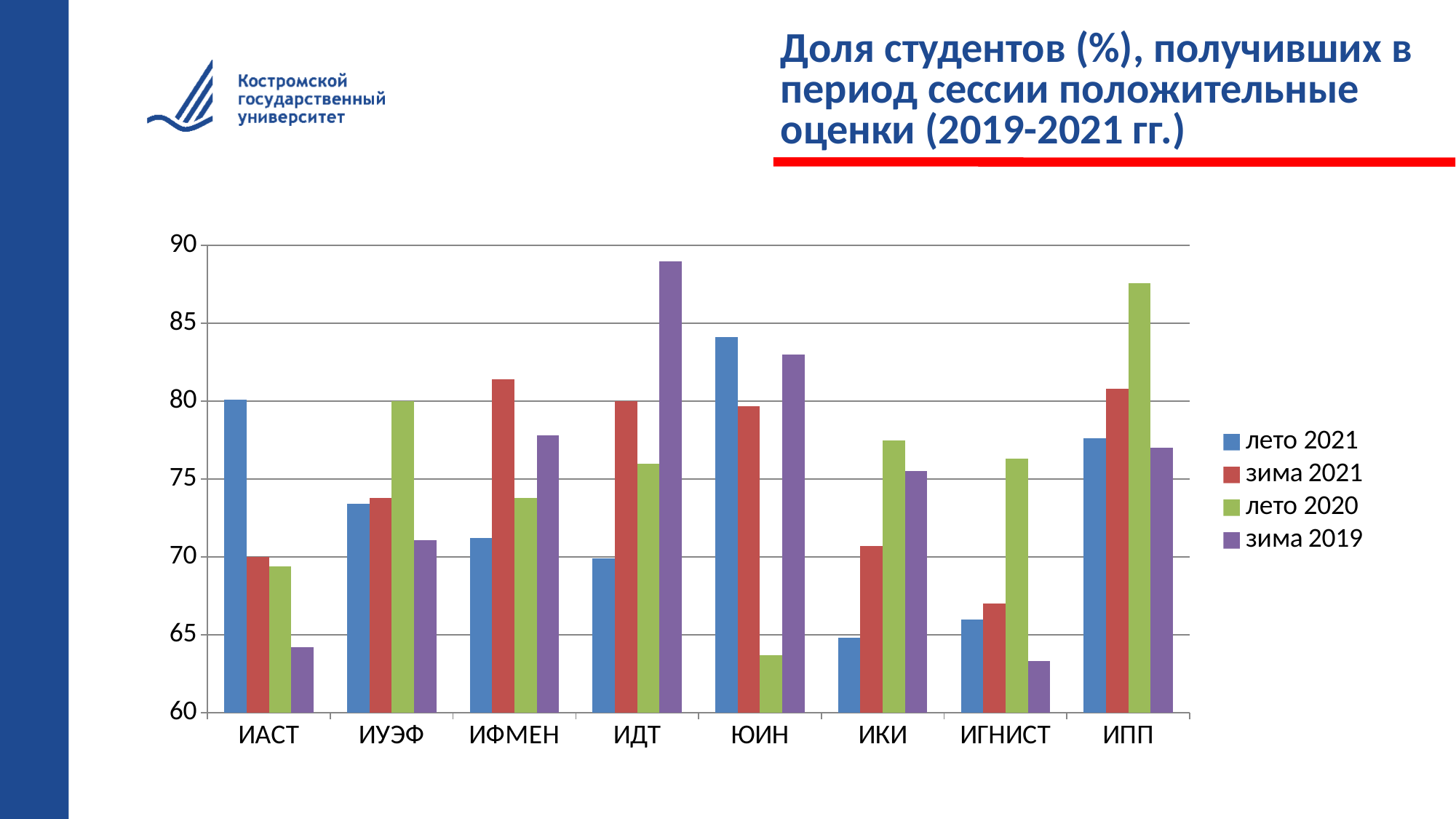
For ИАСТ, which series has the highest value? лето 2021 How many series does the legend list? 4 How many categories (institutes) are shown on the x axis? 8 Which category has the tallest bar in the whole chart? ИДТ Is the value for ЮИН in лето 2020 greater or less than 65? less For ИДТ, which series has the highest value? зима 2019 What kind of chart is shown on the slide? bar chart Is the value for ИФМЕН in зима 2021 greater or less than 80? greater For ЮИН, which is larger: the value for лето 2021 or the value for лето 2020? лето 2021 Is the value for ИАСТ in зима 2019 greater or less than 65? less Which series is shown in green in the legend? лето 2020